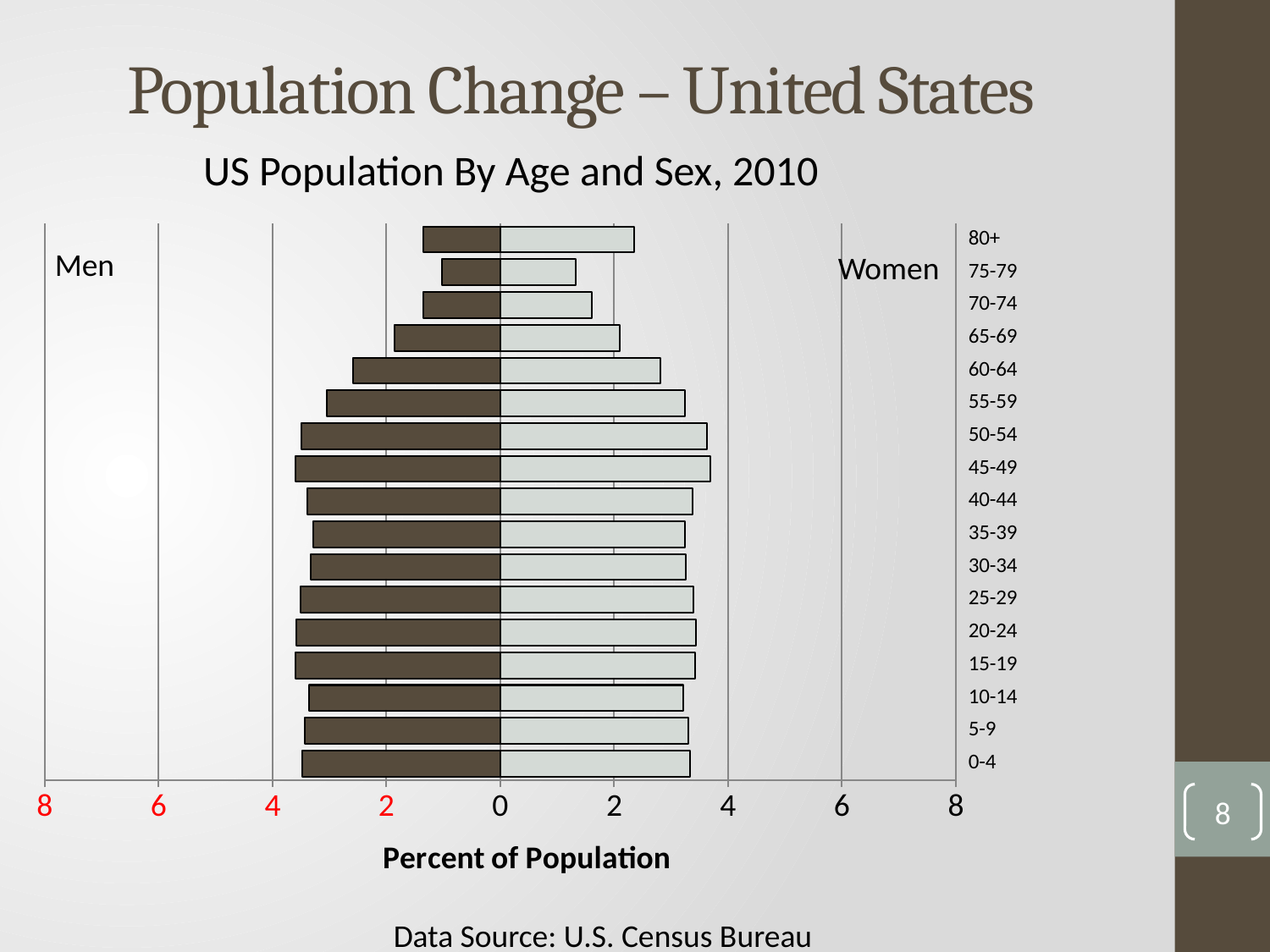
What is the title of the horizontal axis? Percent of Population Is the value for Men aged 65-69 greater or less than 2? less For Men, which is larger, the value for 60-64 or the value for 70-74? 60-64 How many age groups are shown on the chart? 17 Which age group has the shortest bar for Women? 75-79 How many series (sexes) does the chart show? 2 What kind of chart is shown on the slide? bar chart For the 80+ age group, which is larger, the Men value or the Women value? Women Is the value for Women aged 45-49 greater or less than 4? less Is the value for Women aged 80+ greater or less than 2? greater Which age group has the shortest bar for Men? 75-79